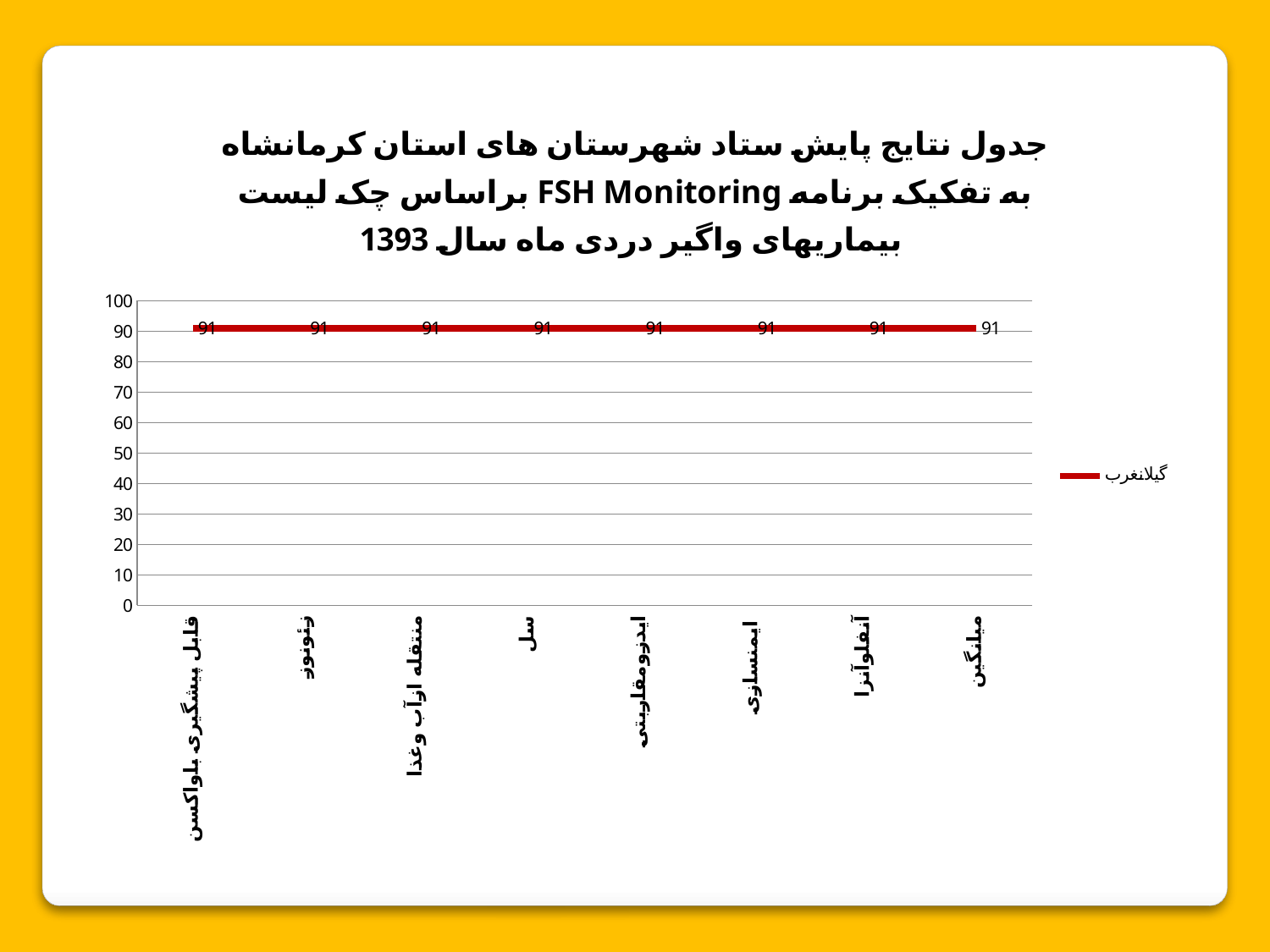
Is the value for قابل پیشگیری با واکسن greater or less than 80? greater What is the name of the series shown in the legend? گیلانغرب What is the difference between the values for ایمنسازی and سل? 0 What is the value for زئونوز? 91 What kind of chart is shown on the slide? line chart What is the value for سل? 91 What is the value for میانگین? 91 How many series does the legend list? 1 What is the value for آنفلوآنزا? 91 How many categories are shown on the x axis? 8 Do the values rise, fall, or stay flat across the categories? stay flat Is the value for منتقله از آب و غذا greater or less than 100? less